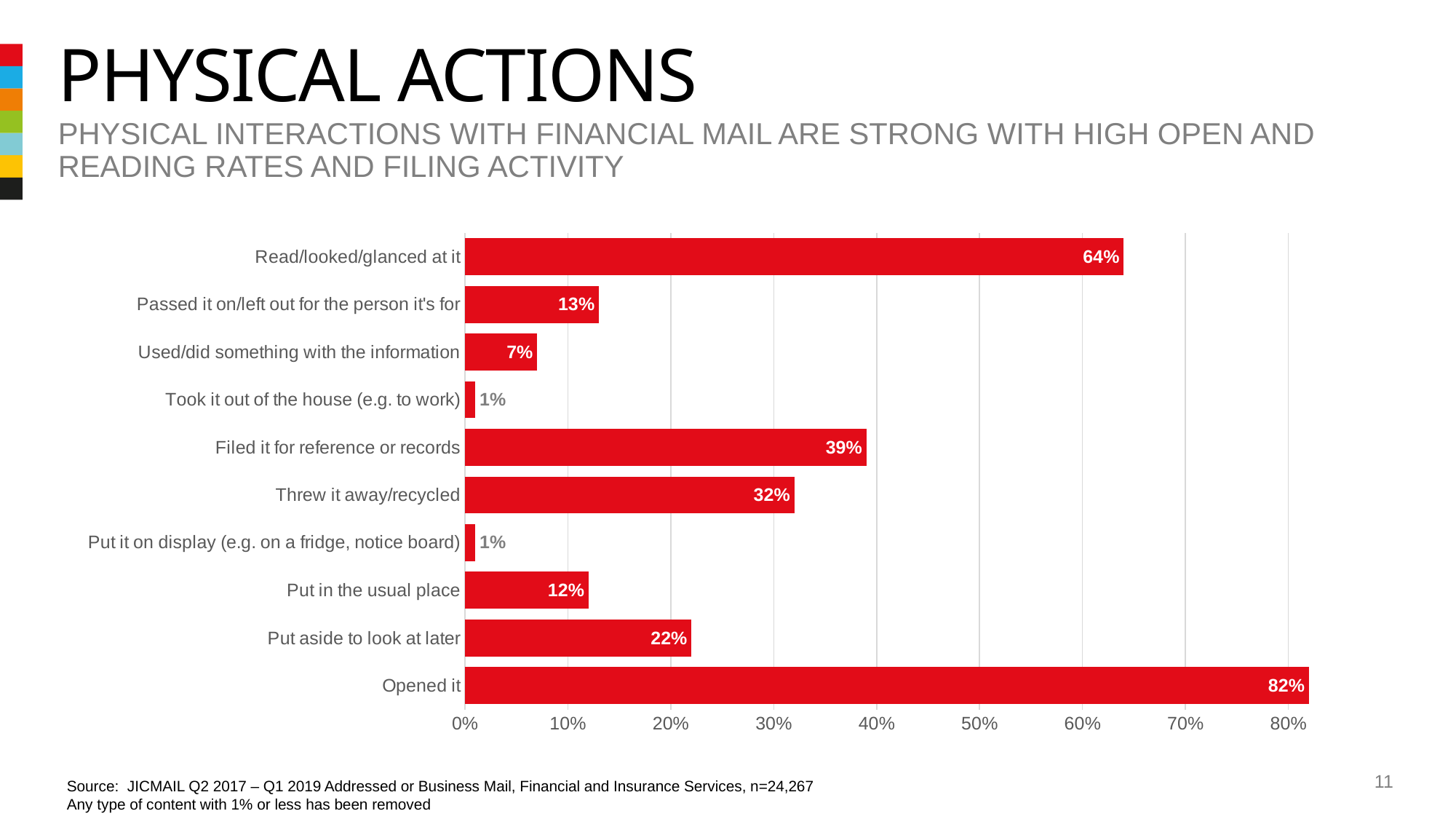
Is the value for "Threw it away/recycled" greater or less than 30%? greater Which category has the highest value? Opened it What is the difference between "Opened it" and "Read/looked/glanced at it"? 18% What is the value for "Opened it"? 82% What is the difference between "Filed it for reference or records" and "Threw it away/recycled"? 7% How many categories are shown in the chart? 10 What kind of chart is shown on the slide? Bar chart Which is larger: "Passed it on/left out for the person it's for" or "Put in the usual place"? Passed it on/left out for the person it's for What is the value for "Filed it for reference or records"? 39% What colour are the bars in the chart? Red What is the value for "Put aside to look at later"? 22% Which category has the lowest value, excluding the two categories tied at 1%? Used/did something with the information